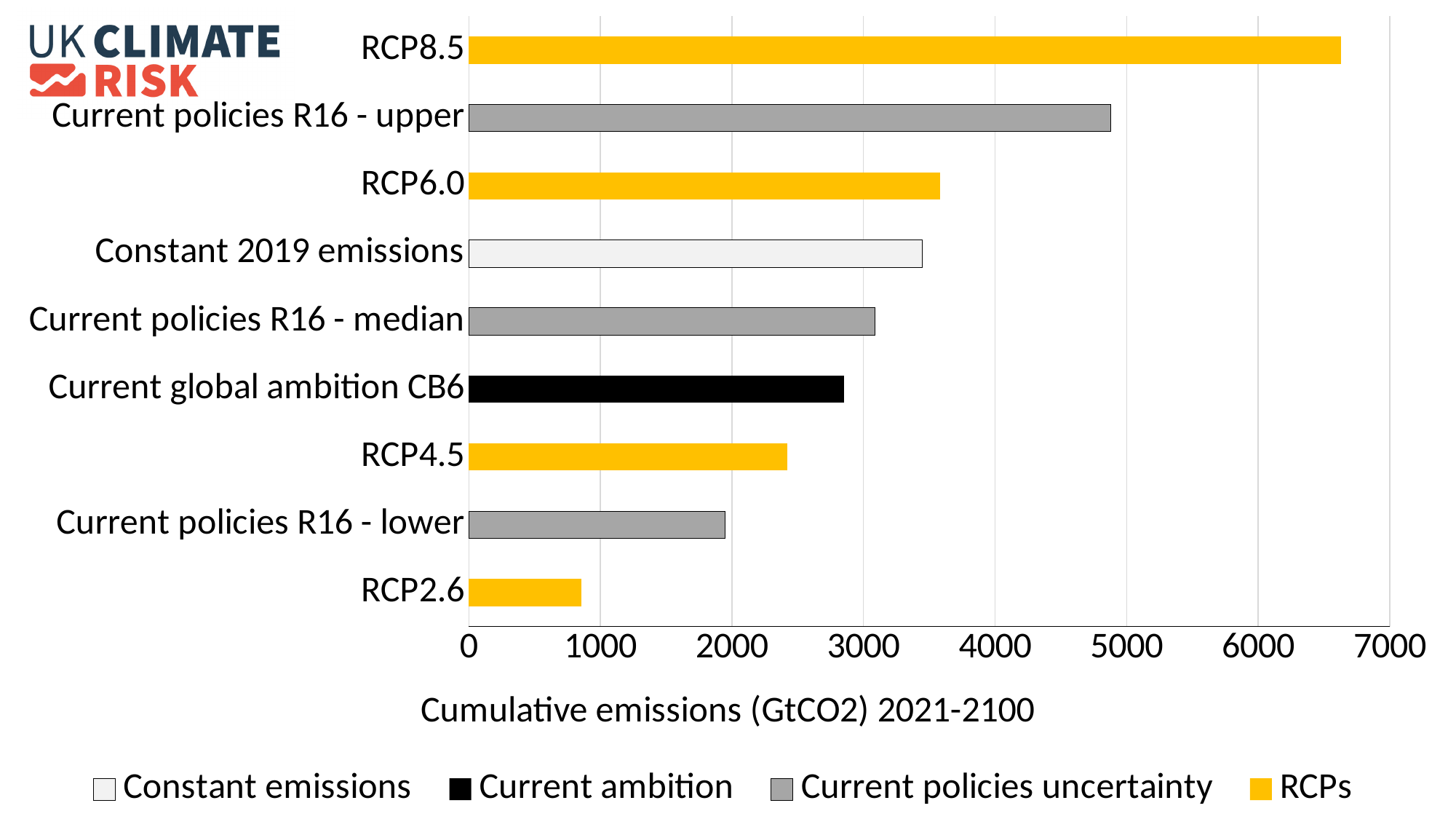
Is the value for RCP2.6 greater or less than 1000? less What is the label of the horizontal axis? Cumulative emissions (GtCO2) 2021-2100 Which is larger, the value for RCP6.0 or the value for RCP4.5? RCP6.0 How many categories (bars) are plotted on the chart? 9 Is the value for Current policies R16 - upper greater or less than 5000? less Which is larger, the value for Current policies R16 - lower or the value for Current global ambition CB6? Current global ambition CB6 Is the value for Current global ambition CB6 greater or less than 2000? greater Which category has the highest cumulative emissions? RCP8.5 What kind of chart is shown on the slide? bar chart How many series does the legend list? 4 Which category has the lowest cumulative emissions? RCP2.6